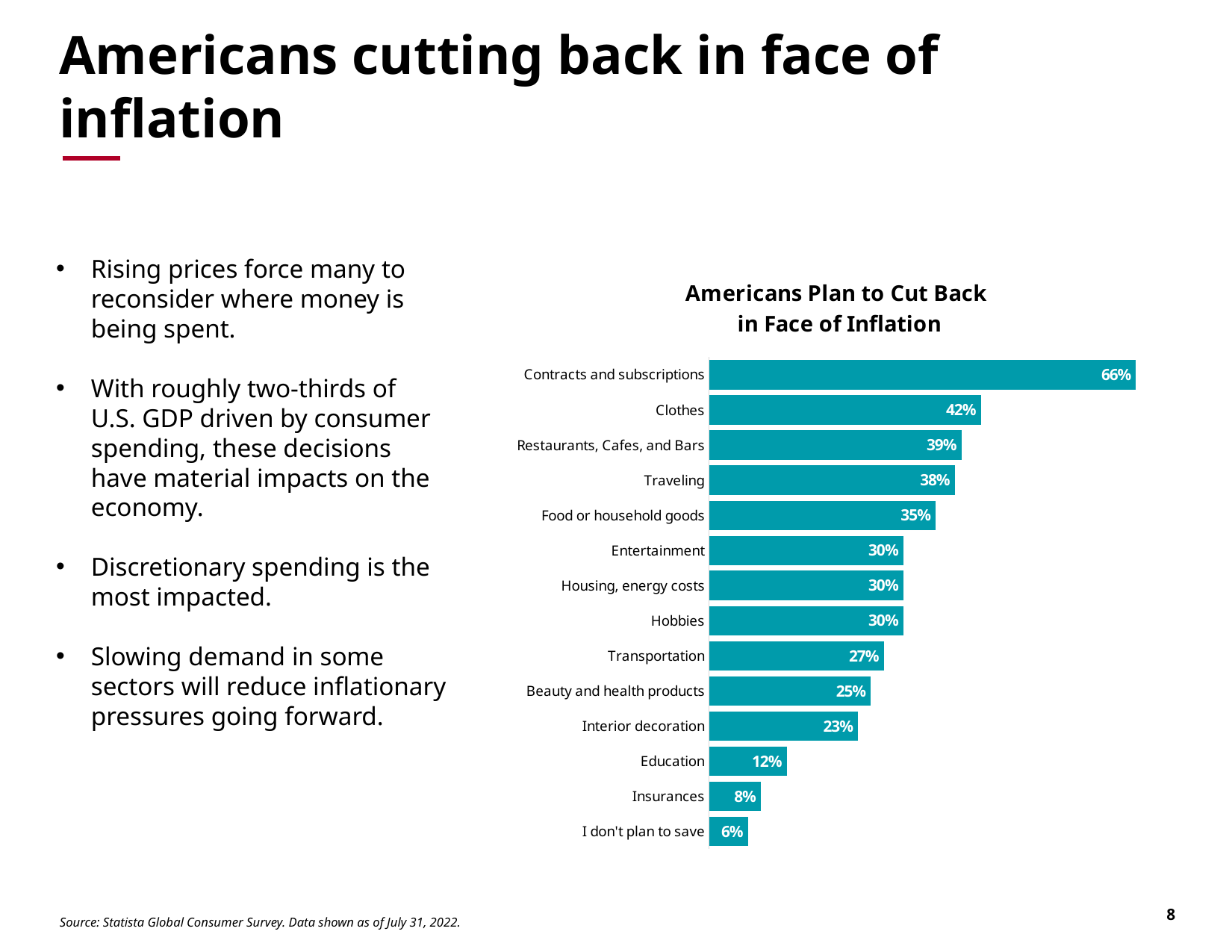
What is the difference between the values for Contracts and subscriptions and Food or household goods? 31% What percentage of Americans plan to cut back on contracts and subscriptions? 66% How many categories are shown in the chart? 14 Which category has the highest value in the chart? Contracts and subscriptions Which category has the lowest value in the chart? I don't plan to save What percentage is shown for Education? 12% What is the title of the chart? Americans Plan to Cut Back in Face of Inflation Which is larger, the value for Restaurants, Cafes, and Bars or the value for Beauty and health products? Restaurants, Cafes, and Bars What is the value shown for Traveling? 38% What is the difference between the values for Clothes and Insurances? 34% What type of chart is shown on the slide? Bar chart Which is larger, the value for Transportation or the value for Interior decoration? Transportation